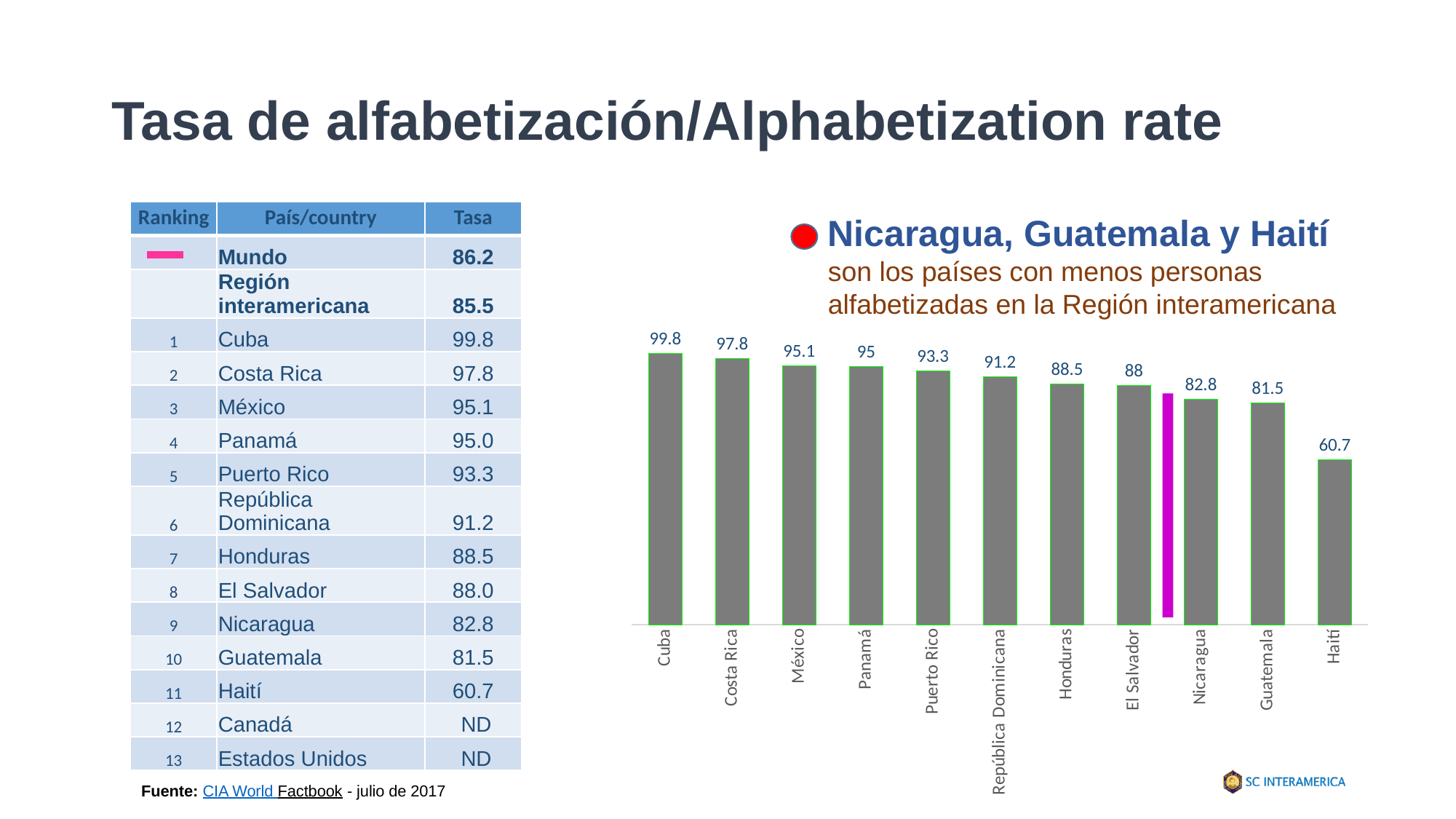
Do the values in the bar chart rise or fall from left to right? Fall Which country has the lowest value in the bar chart? Haití What is the value shown for Nicaragua in the bar chart? 82.8 What is the value shown for Haití in the bar chart? 60.7 What is the difference between the values for Nicaragua and Guatemala in the bar chart? 1.3 How many countries are labelled on the x axis of the bar chart? 11 What is the value shown for Cuba in the bar chart? 99.8 Which country has the highest value in the bar chart? Cuba Which has a larger value in the bar chart, Honduras or Guatemala? Honduras What is the difference between the values for Cuba and Haití in the bar chart? 39.1 What kind of chart is shown on the slide? Bar chart What is the value shown for República Dominicana in the bar chart? 91.2